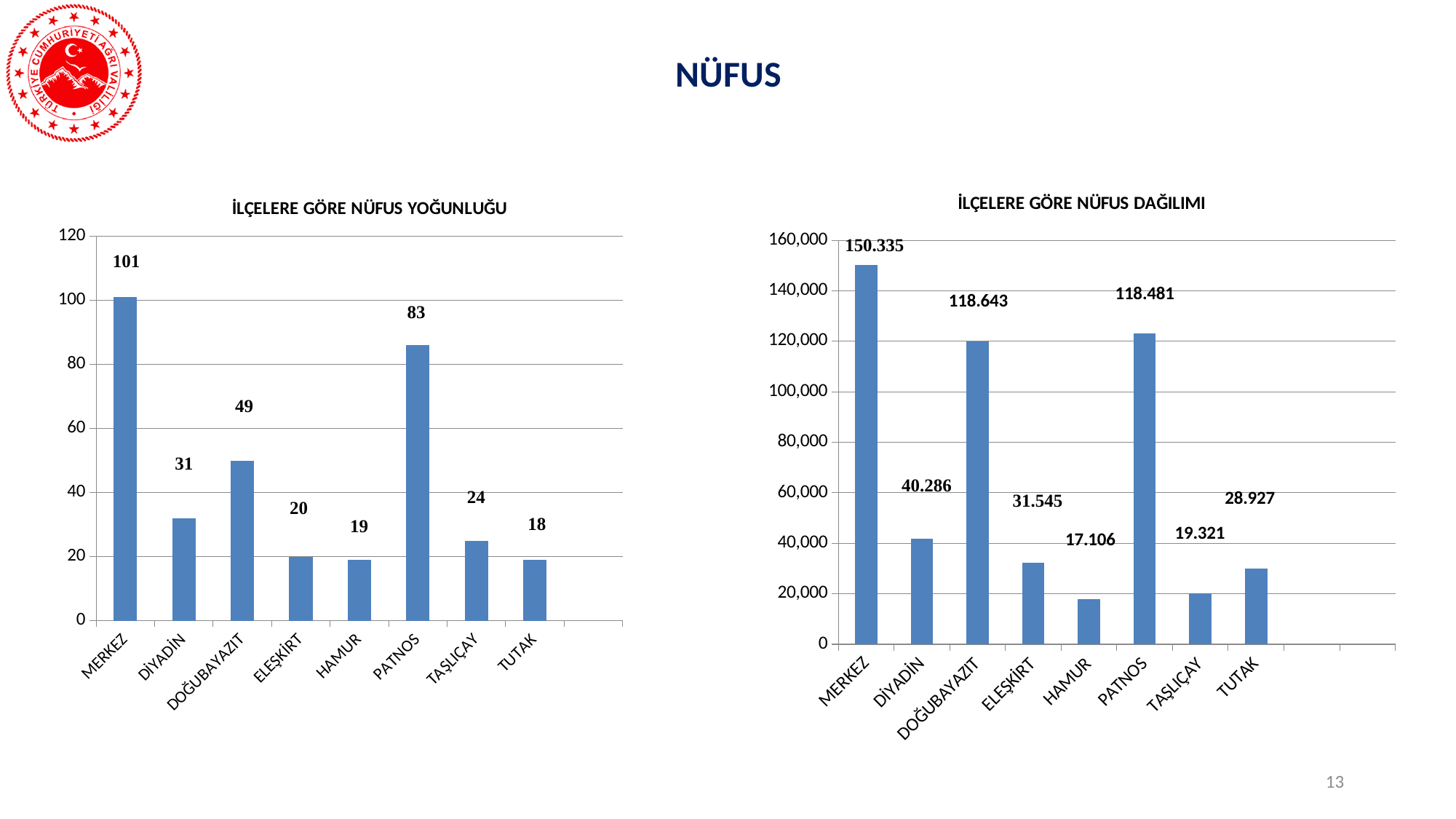
In the İLÇELERE GÖRE NÜFUS DAĞILIMI chart, what is the value for HAMUR? 17.106 In the İLÇELERE GÖRE NÜFUS YOĞUNLUĞU chart, what is the difference between the values for MERKEZ and PATNOS? 18 In the İLÇELERE GÖRE NÜFUS YOĞUNLUĞU chart, what is the value for PATNOS? 83 In the İLÇELERE GÖRE NÜFUS YOĞUNLUĞU chart, which is larger, the value for DİYADİN or the value for DOĞUBAYAZIT? DOĞUBAYAZIT In the İLÇELERE GÖRE NÜFUS DAĞILIMI chart, what is the value for MERKEZ? 150.335 What type of chart is the İLÇELERE GÖRE NÜFUS DAĞILIMI chart? bar chart In the İLÇELERE GÖRE NÜFUS YOĞUNLUĞU chart, how many districts are shown? 8 In the İLÇELERE GÖRE NÜFUS DAĞILIMI chart, which is larger, the value for TAŞLIÇAY or the value for TUTAK? TUTAK In the İLÇELERE GÖRE NÜFUS DAĞILIMI chart, which district has the lowest value? HAMUR In the İLÇELERE GÖRE NÜFUS DAĞILIMI chart, is the value for DİYADİN greater or less than 60,000? less In the İLÇELERE GÖRE NÜFUS YOĞUNLUĞU chart, which district has the highest value? MERKEZ